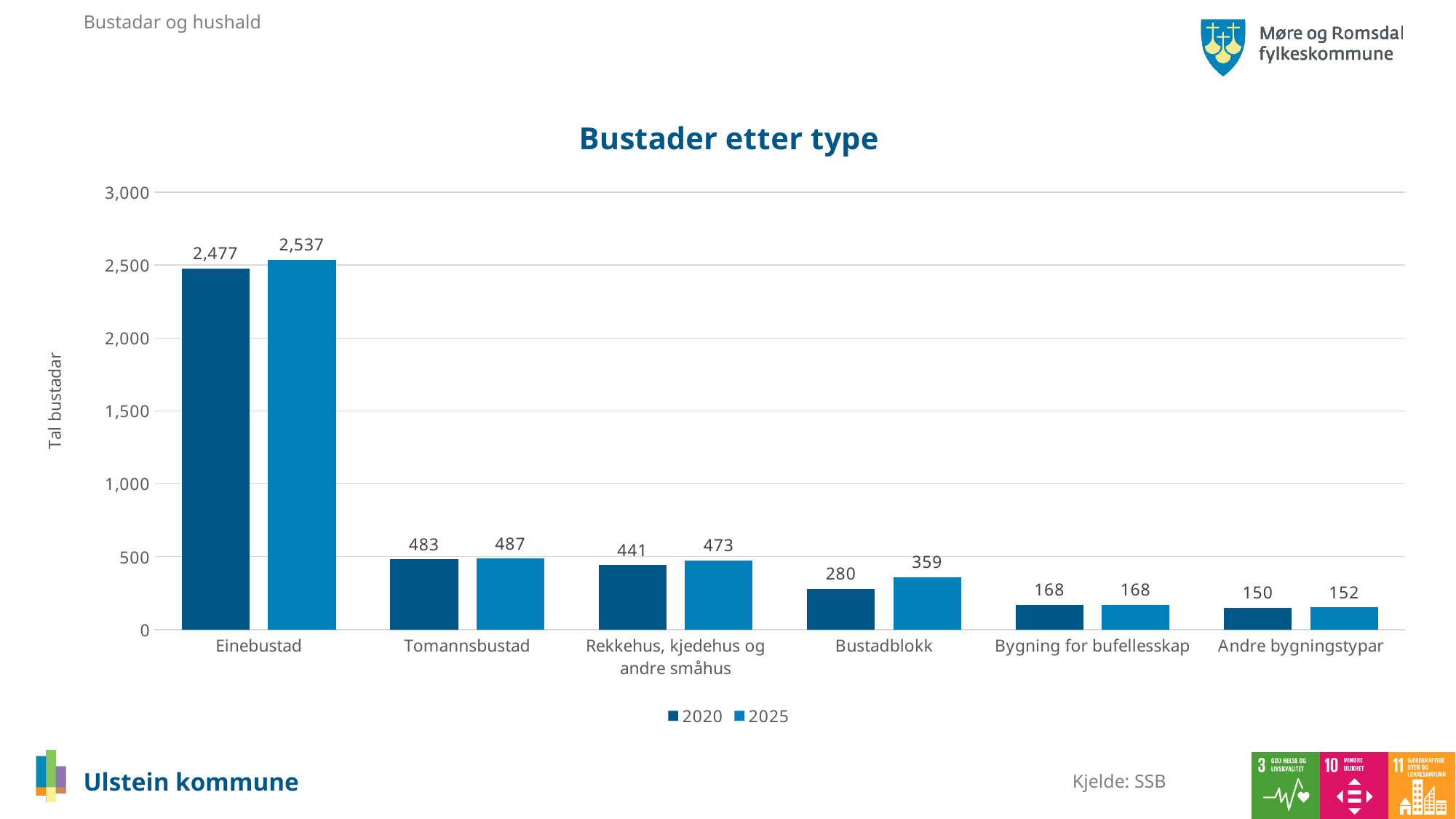
What is the value for Einebustad in 2025? 2,537 How many series does the legend list? 2 Which category has the lowest value in 2025? Andre bygningstypar What kind of chart is shown? Bar chart What is the title of the chart? Bustader etter type What is the value for Bustadblokk in 2020? 280 What is the difference between the 2025 and 2020 values for Bustadblokk? 79 Which category has the highest value in 2020? Einebustad Which is larger for Tomannsbustad, the 2020 value or the 2025 value? 2025 How many categories are shown on the x axis? 6 What is the value for Rekkehus, kjedehus og andre småhus in 2025? 473 What is the difference between the 2025 and 2020 values for Einebustad? 60